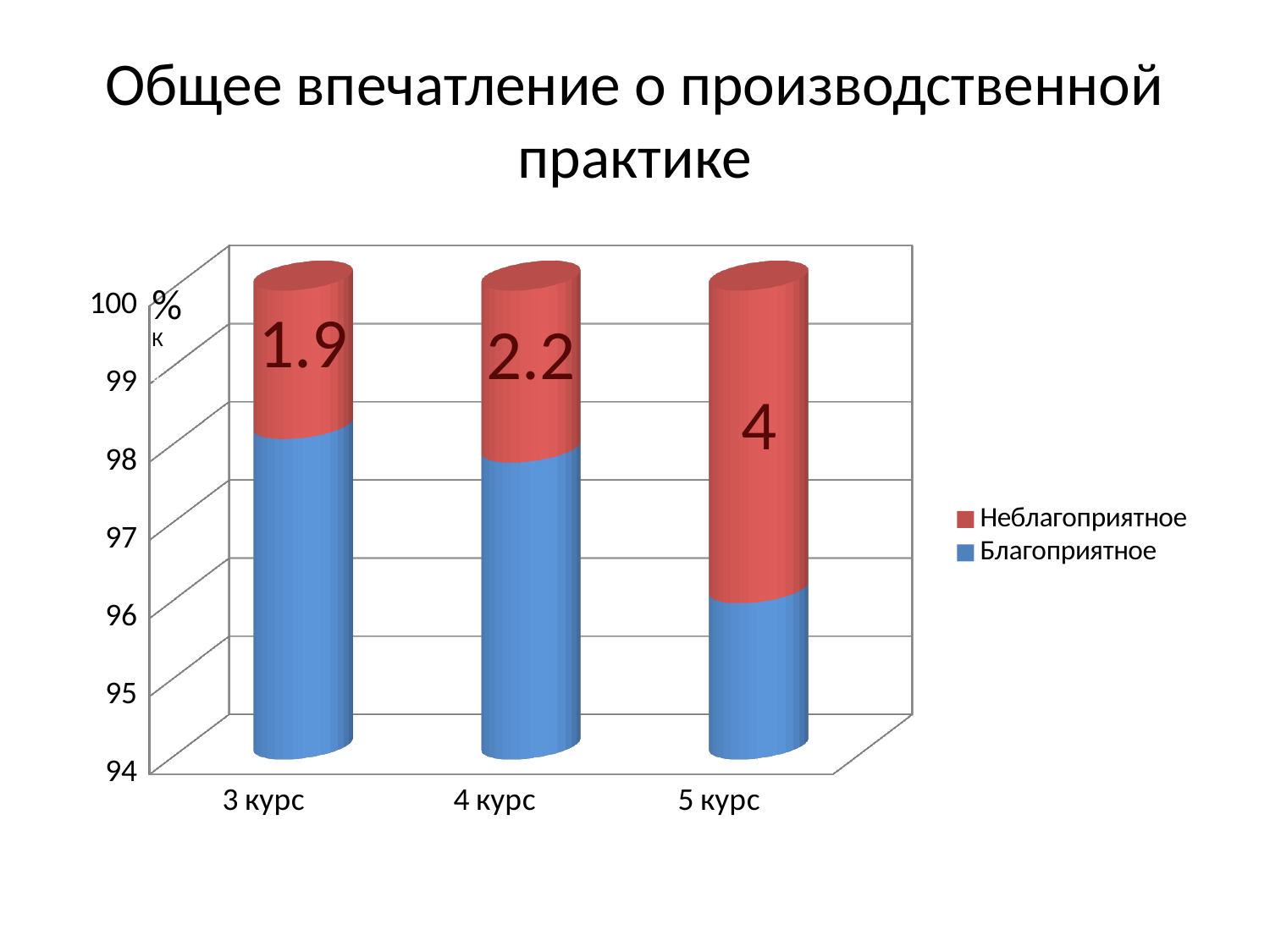
Which course has the highest Неблагоприятное value? 5 курс How many courses are shown on the x axis? 3 What is the value of Неблагоприятное for 4 курс? 2.2 Which course has the lowest Неблагоприятное value? 3 курс Is the Благоприятное value for 3 курс greater or less than 97? greater What is the value of Неблагоприятное for 3 курс? 1.9 How many series does the legend list? 2 What is the value of Неблагоприятное for 5 курс? 4 What is the difference between the Неблагоприятное values for 5 курс and 3 курс? 2.1 Which is larger, the Неблагоприятное value for 4 курс or for 3 курс? 4 курс Is the Благоприятное value for 5 курс greater or less than 97? less Does the Неблагоприятное value rise or fall from 3 курс to 5 курс? rise